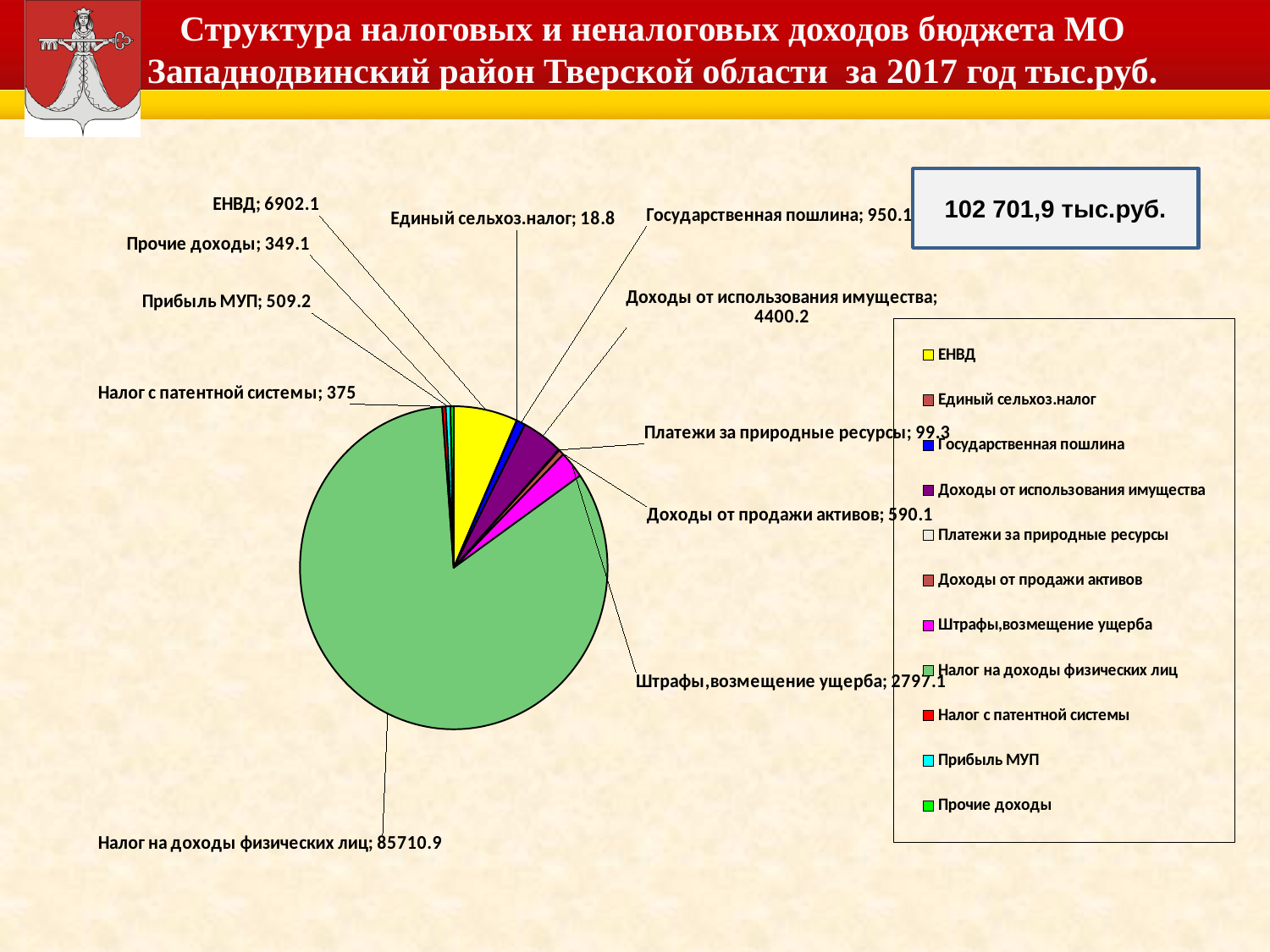
What is the value for Единый сельхоз.налог? 18.8 What kind of chart is shown on the slide? Pie chart Which is larger: Государственная пошлина or Доходы от продажи активов? Государственная пошлина Which category has the largest value in the pie chart? Налог на доходы физических лиц Which category has the smallest value in the pie chart? Единый сельхоз.налог What is the value for Налог на доходы физических лиц? 85710.9 How many categories does the pie chart contain? 11 What total amount is shown in the box at the top right of the slide? 102 701,9 тыс.руб. What is the value for Доходы от использования имущества? 4400.2 What is the difference between Прибыль МУП and Прочие доходы? 160.1 What is the difference between ЕНВД and Доходы от использования имущества? 2501.9 What is the value for Штрафы,возмещение ущерба? 2797.1